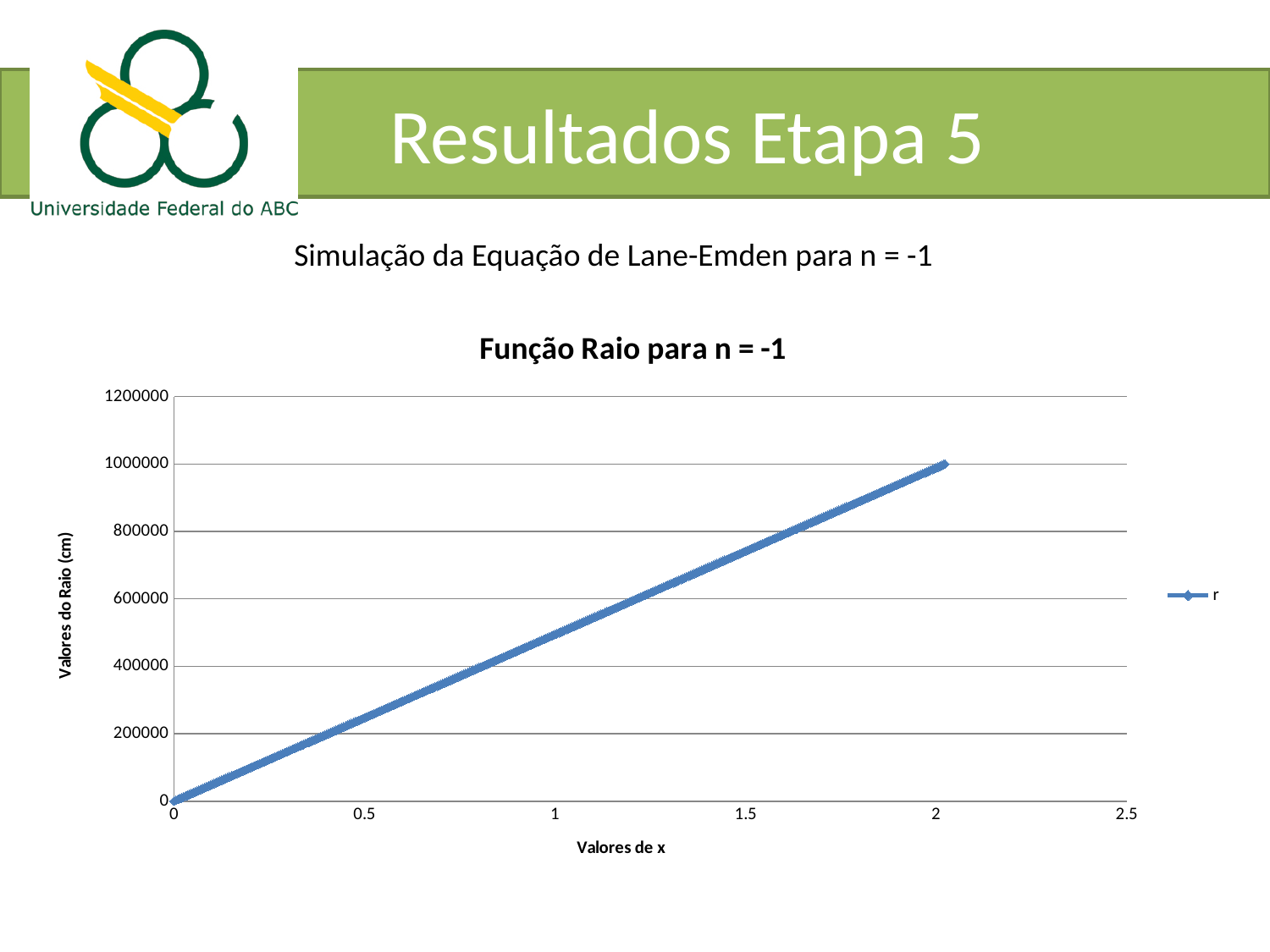
Is the value of r at x = 2 greater or less than 800000? greater Do the values of r rise or fall as x increases along the x axis? rise How many series does the chart legend list? 1 Is the value of r at x = 1 greater or less than 400000? greater What is the name of the series shown in the legend? r Is the value of r at x = 1 greater or less than 600000? less What kind of chart is shown on the slide? line chart What is the title of the chart? Função Raio para n = -1 What is the highest value shown on the y axis? 1200000